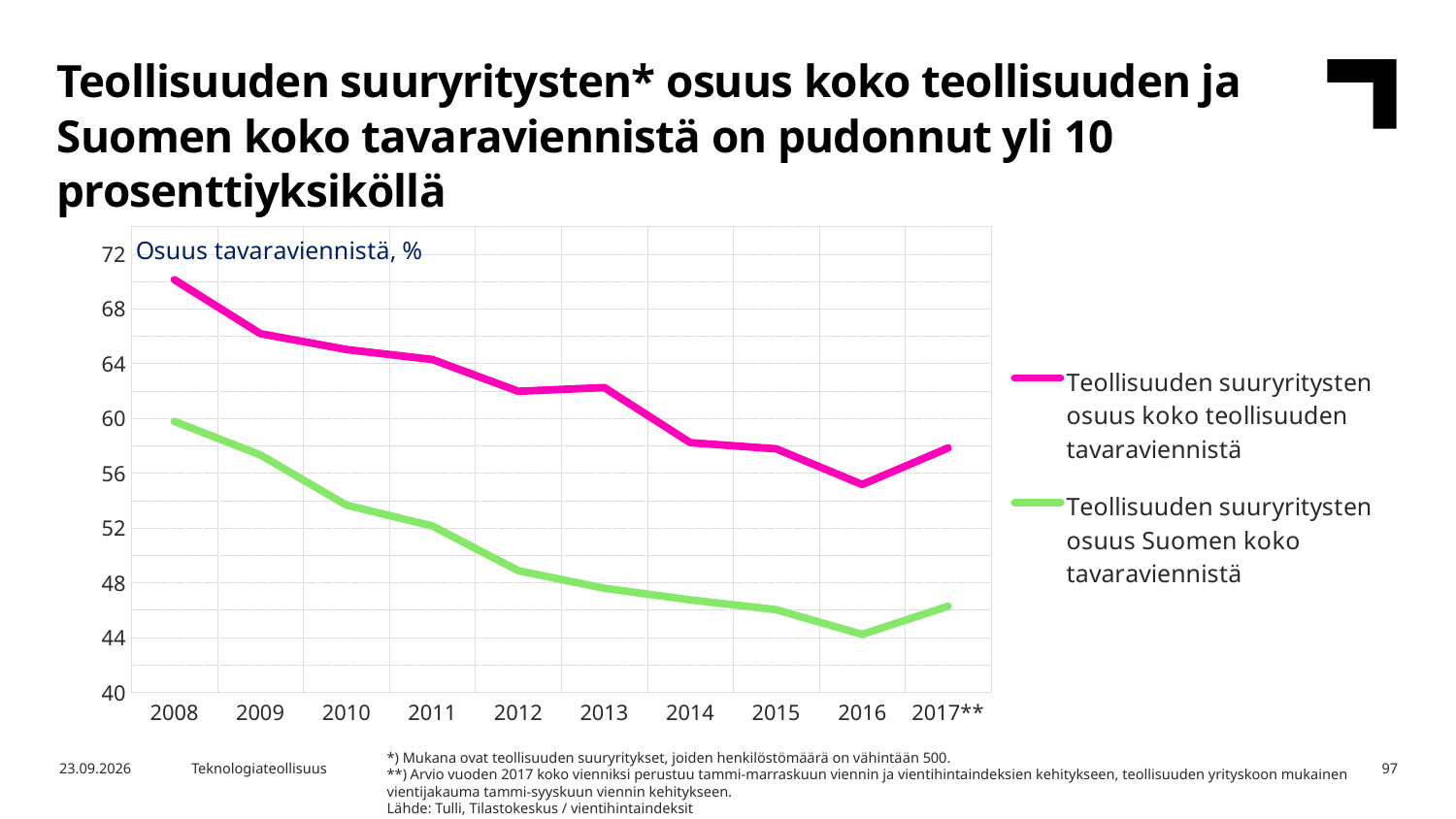
Is the 2008 value of the pink line (share of total industrial goods exports) greater or less than 68? greater In which year is the share of large industrial companies in Finland's total goods exports (green line) lowest? 2016 How many series does the legend list? 2 How many years are plotted along the x axis? 10 In which year is the share of large industrial companies in total industrial goods exports (pink line) lowest? 2016 Which series has the higher value in 2012: the share of total industrial goods exports or the share of Finland's total goods exports? share of total industrial goods exports (Teollisuuden suuryritysten osuus koko teollisuuden tavaraviennistä) Is the 2016 value of the pink line (share of total industrial goods exports) greater or less than 56? less Is the 2015 value of the green line (share of Finland's total goods exports) greater or less than 48? less Does the share of large industrial companies in Finland's total goods exports (green line) generally rise or fall from 2008 to 2016? fall What type of chart is shown on the slide? line chart In which year is the share of large industrial companies in total industrial goods exports (pink line) highest? 2008 What is the label shown at the top of the chart area? Osuus tavaraviennistä, %